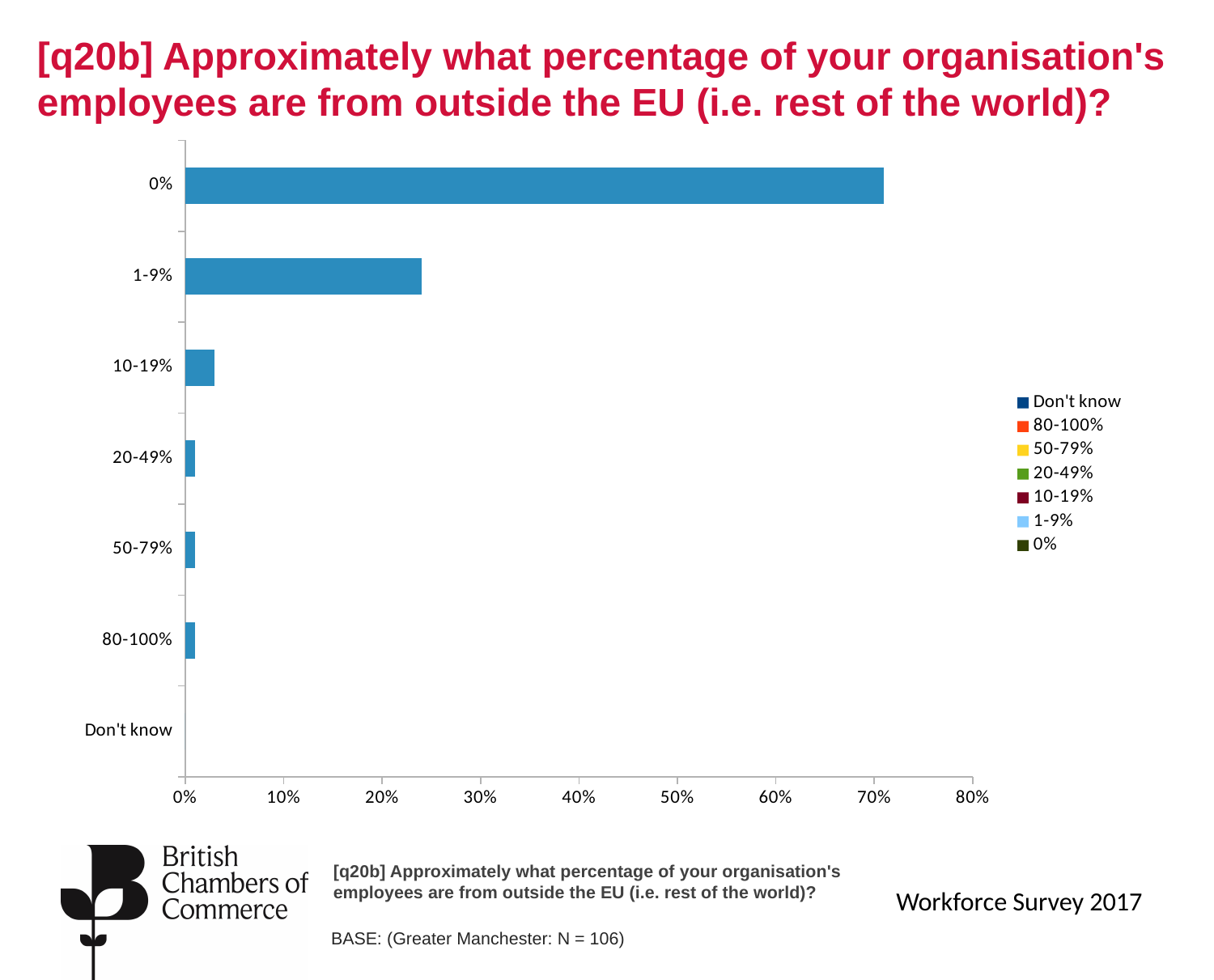
Is the value for the 0% category greater or less than 60%? greater How many entries does the chart's legend list? 7 What kind of chart is shown on the slide? bar chart Is the value for the 1-9% category greater or less than 20%? greater Which category has the shortest bar (no visible bar) in the chart? Don't know Which category has the longest bar in the chart? 0% Which category has the larger value, 1-9% or 10-19%? 1-9% Is the value for the 10-19% category greater or less than 10%? less Which category has the larger value, 0% or 1-9%? 0% What is the highest value shown on the horizontal axis of the chart? 80% How many categories are plotted on the vertical axis of the chart? 7